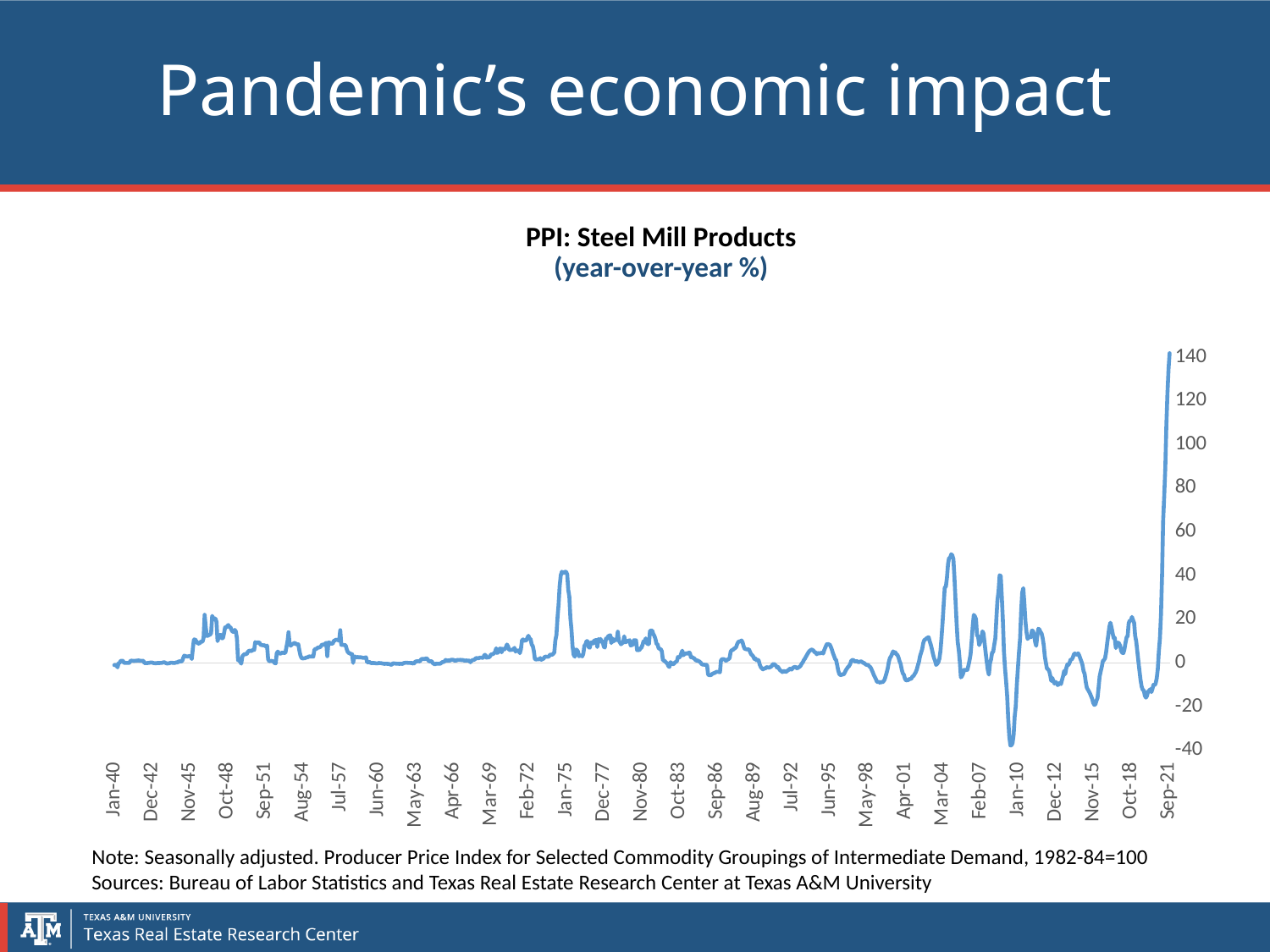
Is the value at Sep-21 greater or less than 100? greater Is the lowest value near Jan-10 greater or less than -20? less Does the line rise or fall overall between Oct-18 and Sep-21? rise At which date label does the line reach its highest value? Sep-21 Near which date label does the line reach its lowest value? Jan-10 Is the value around Jun-60 greater or less than 20? less What is the title of the chart? PPI: Steel Mill Products What kind of chart is shown on the slide? line chart What is the highest value shown on the vertical axis of the chart? 140 Which is higher, the peak near Sep-21 or the peak near Jan-75? Sep-21 How many data series are plotted on the chart? 1